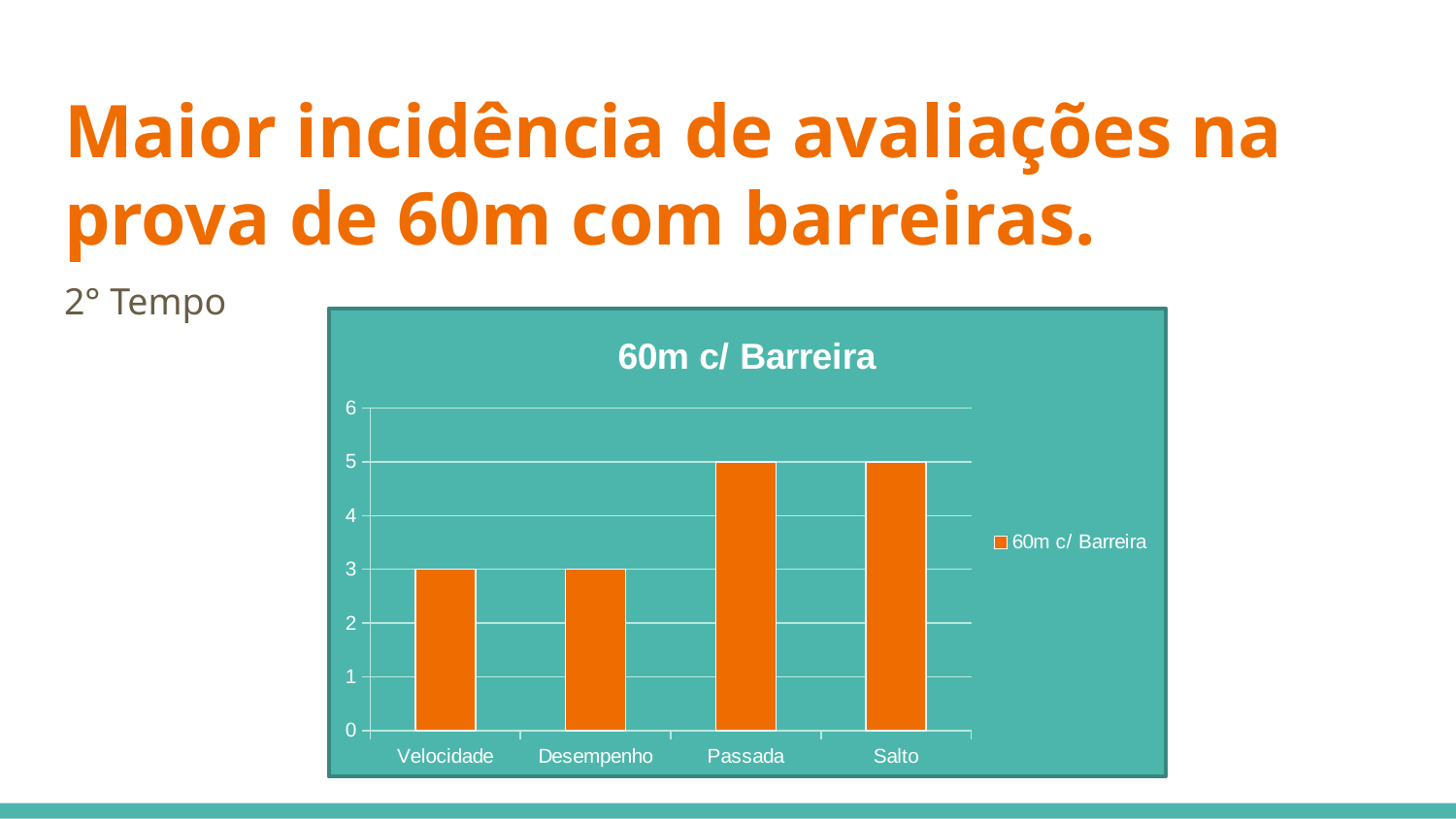
Is the value for Salto greater or less than 4? greater What kind of chart is shown on the slide? bar chart What is the value for Salto in the 60m c/ Barreira chart? 5 What is the value for Passada in the 60m c/ Barreira chart? 5 What is the value for Velocidade in the 60m c/ Barreira chart? 3 How many categories are shown on the x axis of the chart? 4 What is the title of the chart? 60m c/ Barreira What is the value for Desempenho in the 60m c/ Barreira chart? 3 Which has the larger value, Passada or Desempenho? Passada What is the difference between the values for Passada and Velocidade? 2 How many series does the chart legend list? 1 Is the value for Velocidade greater or less than 4? less